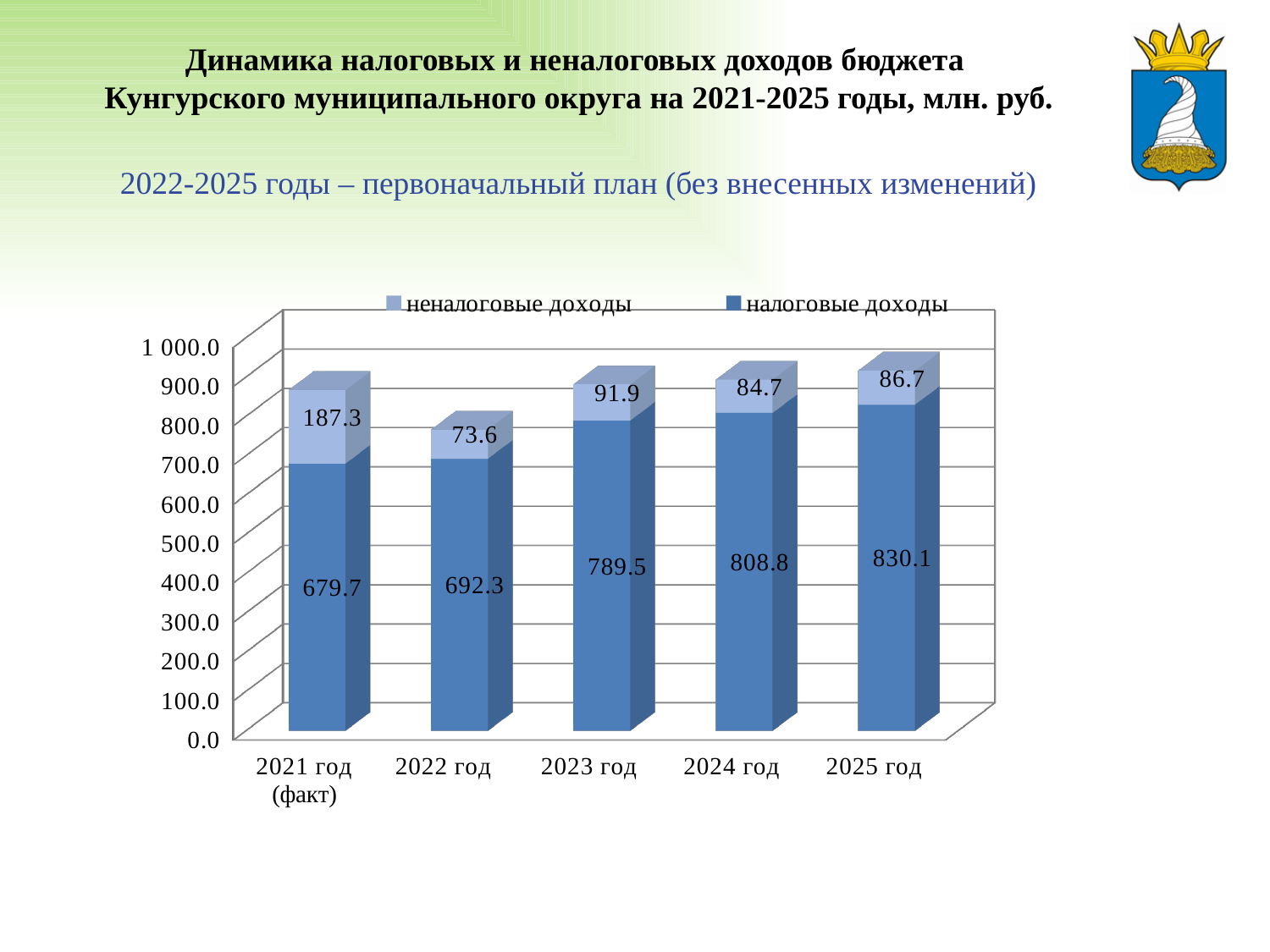
Which year has the lowest value of неналоговые доходы? 2022 год What is the total of the stacked bar for 2022 год? 765.9 Which is larger: неналоговые доходы in 2023 год or in 2025 год? 2023 год What kind of chart is shown on the slide? Stacked bar chart What is the value of налоговые доходы for 2023 год? 789.5 Do the values of налоговые доходы rise or fall from 2021 to 2025? Rise What is the value of неналоговые доходы for 2021 год (факт)? 187.3 Which year has the highest value of налоговые доходы? 2025 год How many years are shown on the x axis? 5 What is the difference between налоговые доходы in 2025 год and 2021 год (факт)? 150.4 What is the value of неналоговые доходы for 2024 год? 84.7 How many series does the legend list? 2